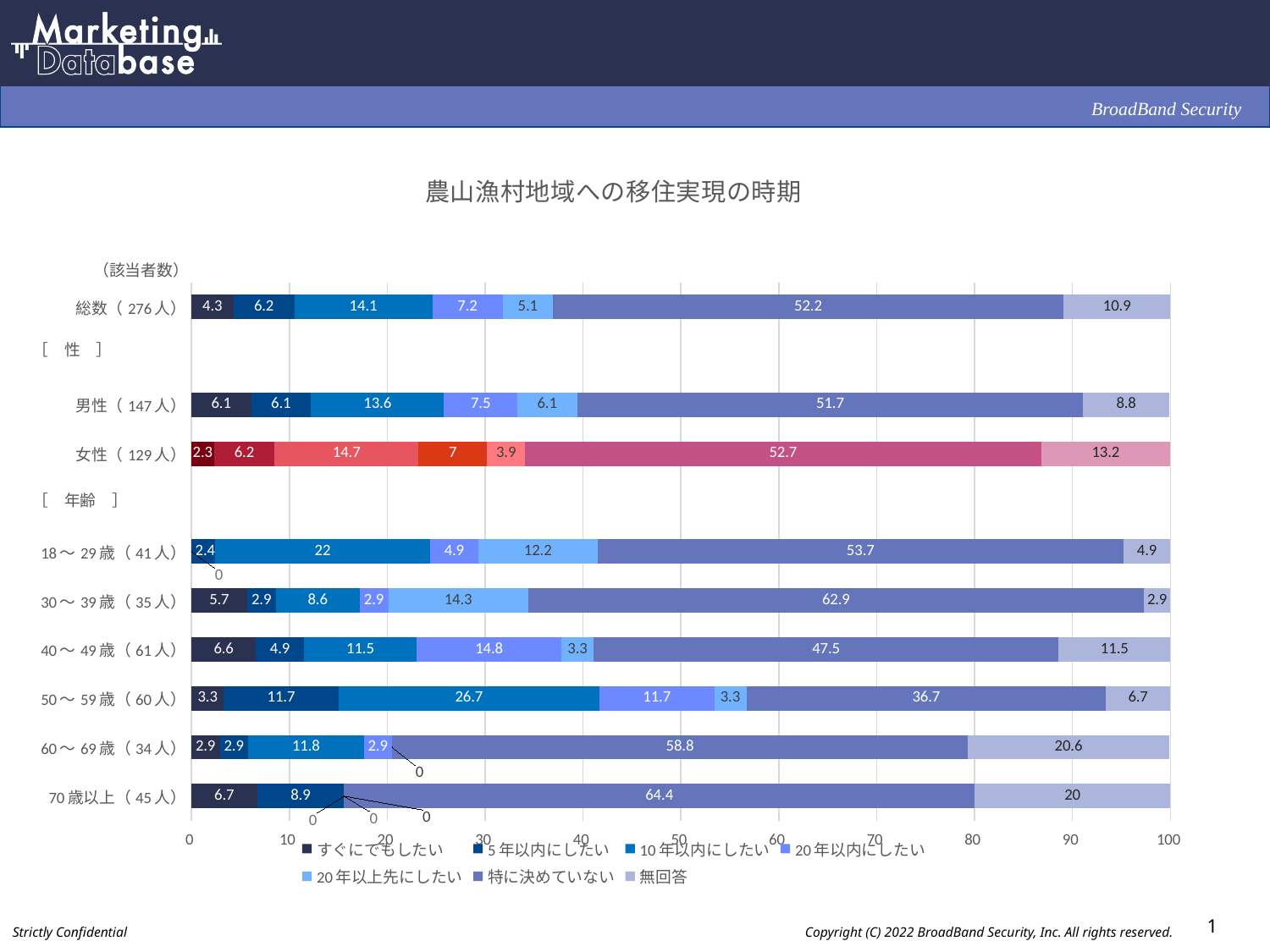
What kind of chart is shown on the slide? stacked bar chart Which category has the highest value for 特に決めていない? 70歳以上 (45人) Which category has the lowest value for 特に決めていない? 50〜59歳 (60人) What is the value of 10年以内にしたい for 50〜59歳 (60人)? 26.7 How many category bars are plotted in the chart? 9 What is the difference between the 無回答 values for 女性 (129人) and 男性 (147人)? 4.4 What is the title of the chart? 農山漁村地域への移住実現の時期 What is the value of 5年以内にしたい for 70歳以上 (45人)? 8.9 Which has a larger value for 20年以上先にしたい, 18〜29歳 (41人) or 30〜39歳 (35人)? 30〜39歳 (35人) What is the value of 特に決めていない for 総数 (276人)? 52.2 What is the value of 無回答 for 60〜69歳 (34人)? 20.6 How many series does the legend list? 7